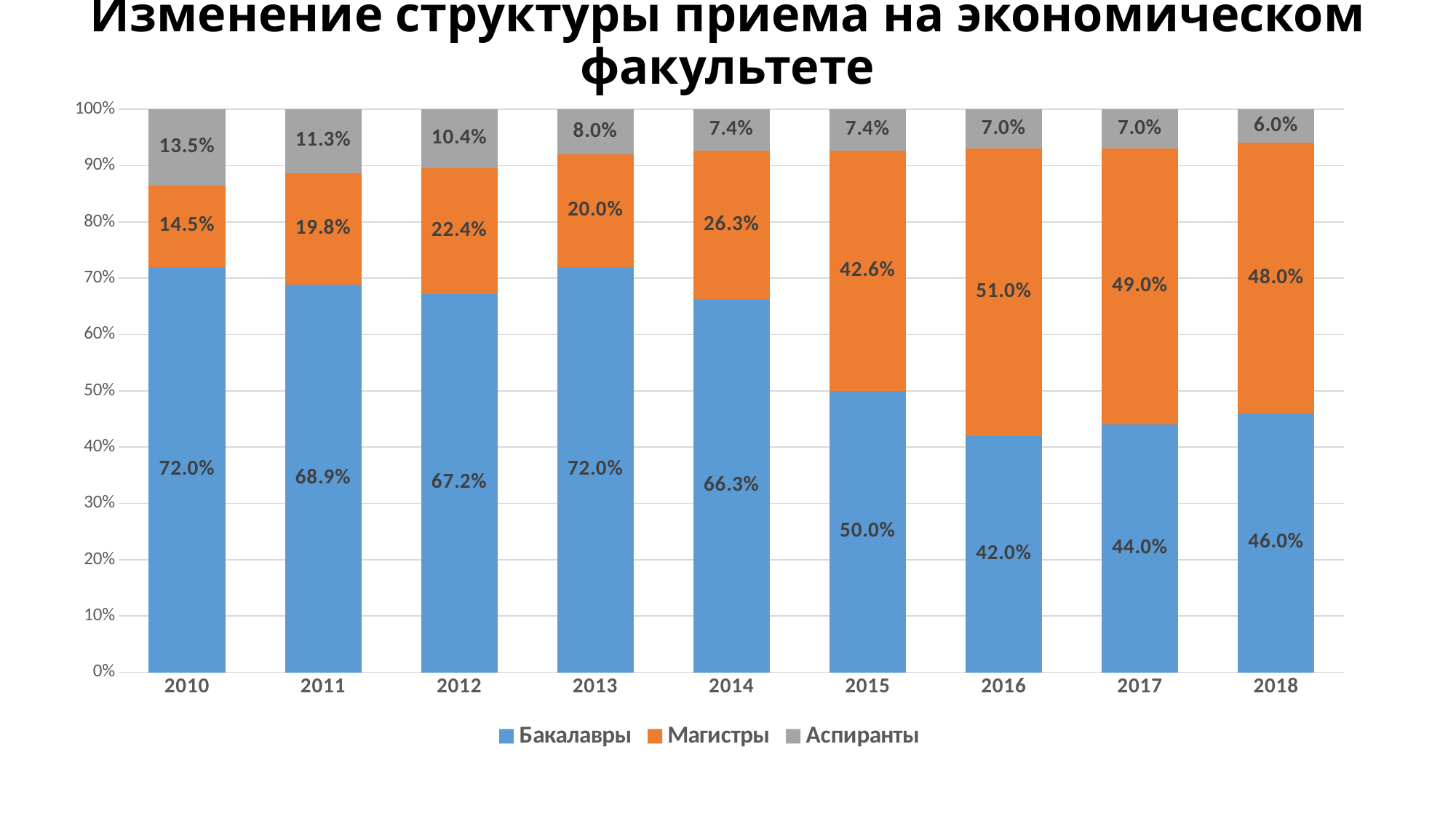
How many series does the legend list? 3 Does the share of Аспиранты rise or fall from 2010 to 2018? Fall How many years are shown on the x axis? 9 In which year is the share of Магистры the highest? 2016 What kind of chart is shown on the slide? Stacked bar chart What is the value for Бакалавры in 2015? 50.0% What is the value for Аспиранты in 2010? 13.5% In 2017, which is larger: the share of Бакалавры or the share of Магистры? Магистры In which year is the share of Бакалавры the lowest? 2016 By how many percentage points did the share of Бакалавры change from 2010 (72.0%) to 2018 (46.0%)? 26.0 percentage points In which year is the share of Аспиранты the lowest? 2018 What is the value for Магистры in 2016? 51.0%